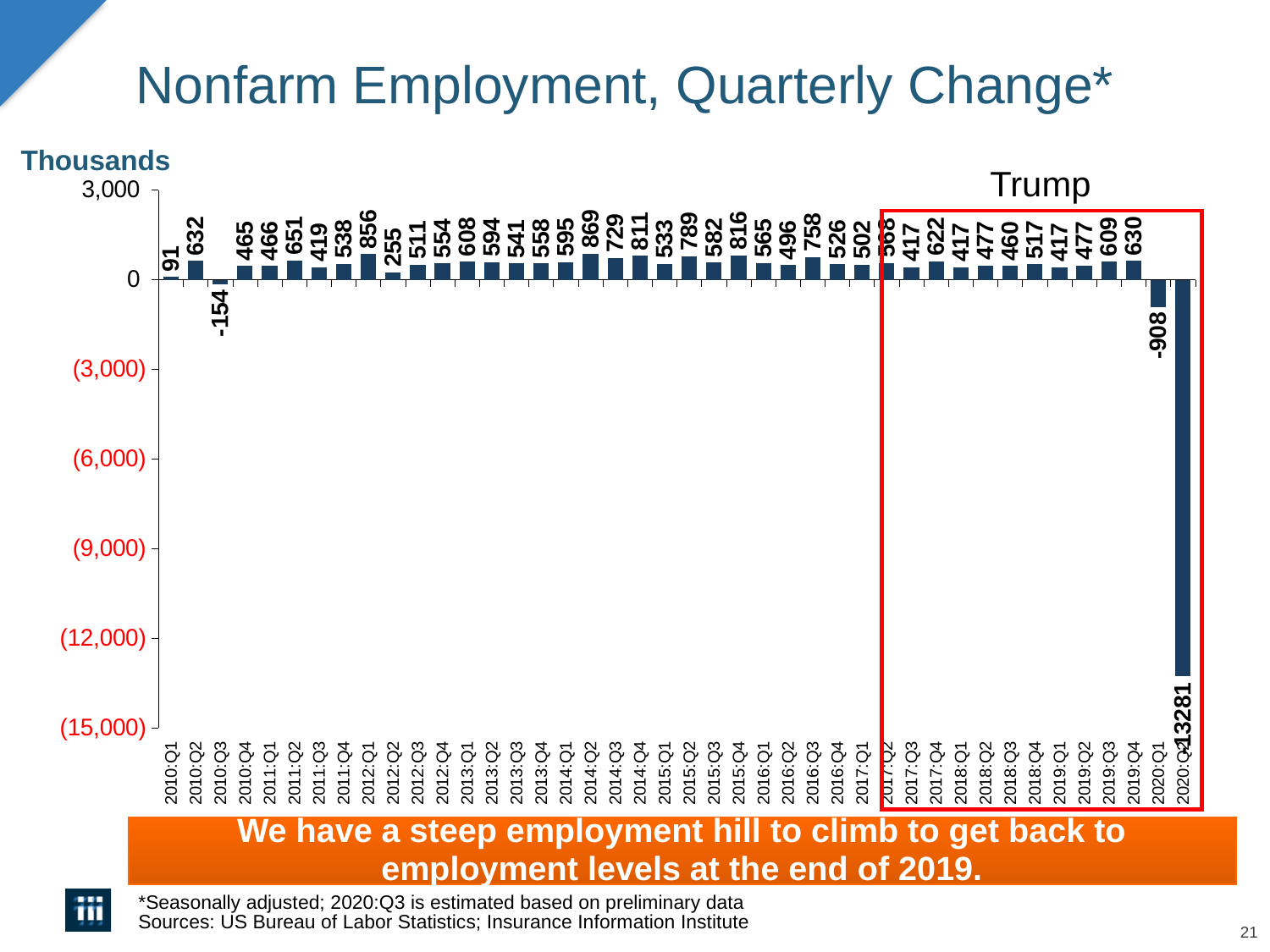
What unit is shown above the y axis of the chart? Thousands What is the quarterly change in nonfarm employment for 2010:Q3? -154 What is the quarterly change in nonfarm employment for 2020:Q1? -908 What is the difference between the quarterly change for 2019:Q4 and 2019:Q3? 21 Which quarter has a larger quarterly change in nonfarm employment, 2012:Q1 or 2012:Q2? 2012:Q1 Is the value for 2020:Q2 greater or less than (12,000)? less Which quarter has the lowest quarterly change in nonfarm employment? 2020:Q2 What is the quarterly change in nonfarm employment for 2019:Q4? 630 What is the quarterly change in nonfarm employment for 2014:Q2? 869 Which quarter has the highest quarterly change in nonfarm employment? 2014:Q2 What kind of chart is shown on the slide? bar chart How many quarters are plotted on the chart? 42